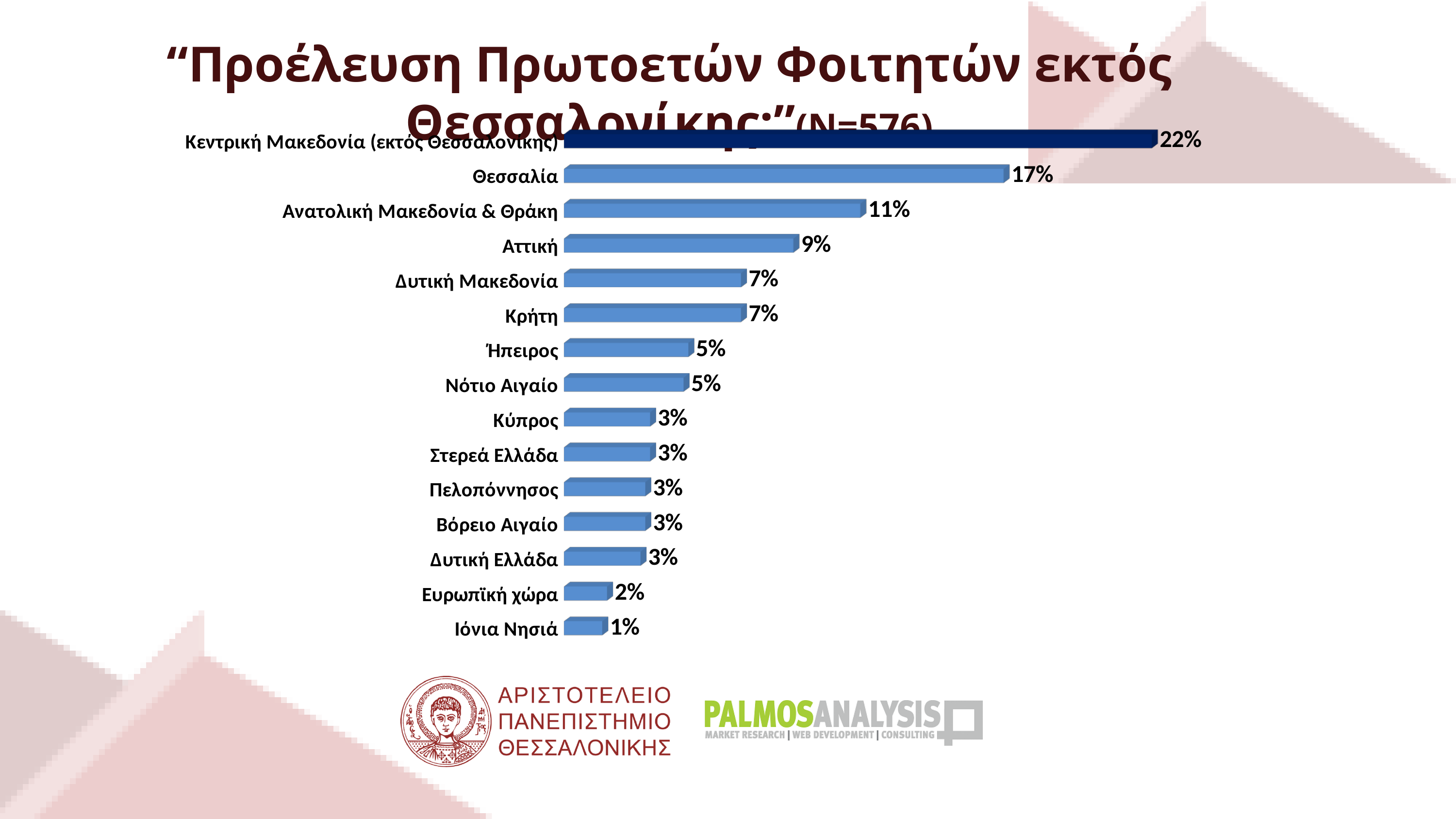
What kind of chart is shown on the slide? Bar chart What is the value for Ανατολική Μακεδονία & Θράκη? 11% What is the value for Ιόνια Νησιά? 1% What is the difference between the values for Κεντρική Μακεδονία (εκτός Θεσσαλονίκης) and Θεσσαλία? 5% What is the value for Θεσσαλία? 17% What is the difference between the values for Αττική and Ήπειρος? 4% Which category has the highest value? Κεντρική Μακεδονία (εκτός Θεσσαλονίκης) Which is larger, the value for Δυτική Μακεδονία or the value for Κύπρος? Δυτική Μακεδονία How many categories are shown in the chart? 15 Which bar is shown in a different (dark navy) colour from the others? Κεντρική Μακεδονία (εκτός Θεσσαλονίκης) What is the value for Αττική? 9% Which category has the lowest value? Ιόνια Νησιά